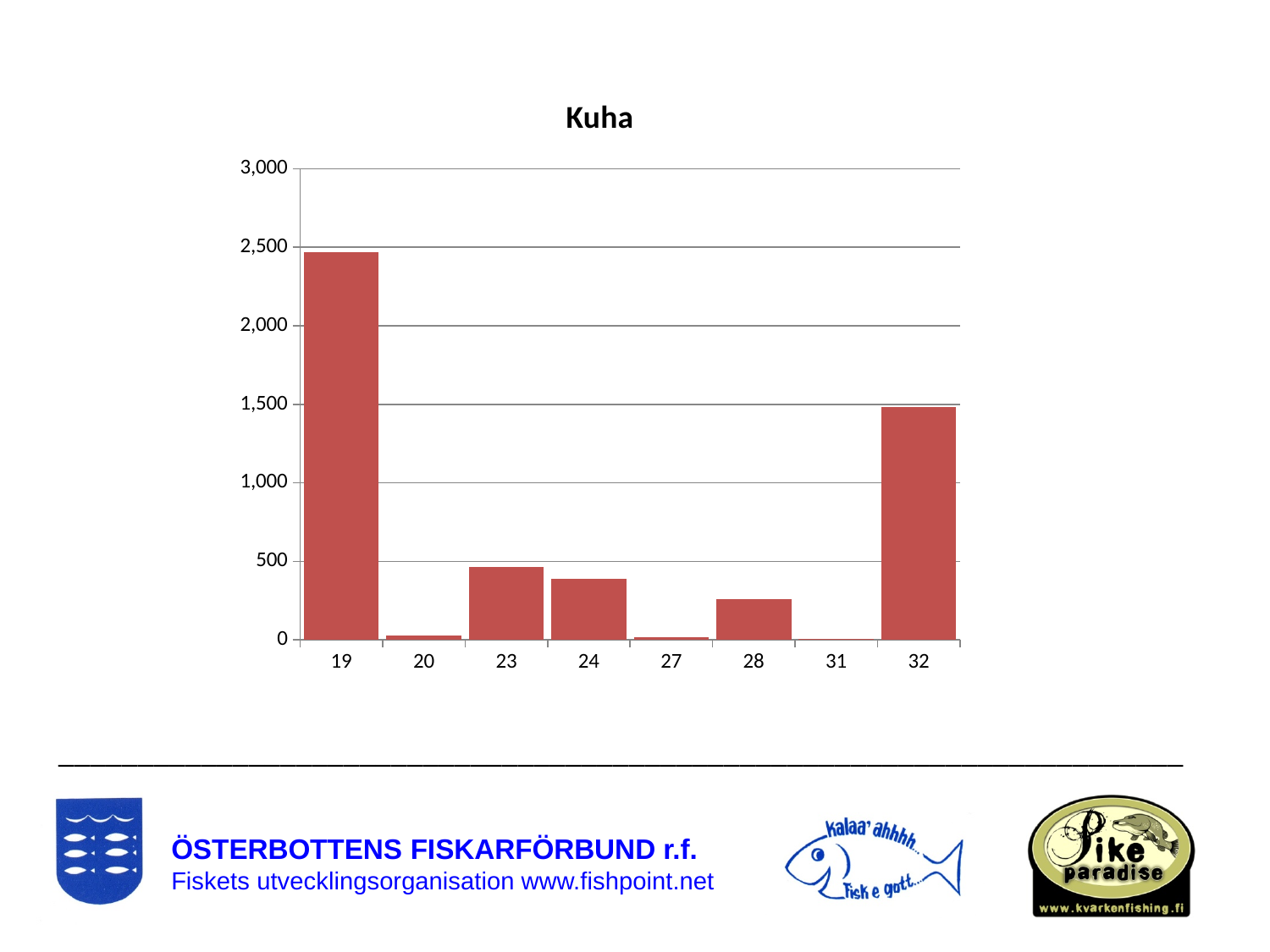
Which category has the lowest value in the chart? 31 How many categories are shown on the x axis of the chart? 8 What is the title of the chart? Kuha Is the value for category 23 greater or less than 500? less What kind of chart is shown on the slide? bar chart Which has the larger value, category 23 or category 24? 23 Which category has the highest value in the chart? 19 Is the value for category 28 greater or less than 500? less Which has the larger value, category 19 or category 32? 19 What colour are the bars in the chart? red Is the value for category 19 greater or less than 2,000? greater